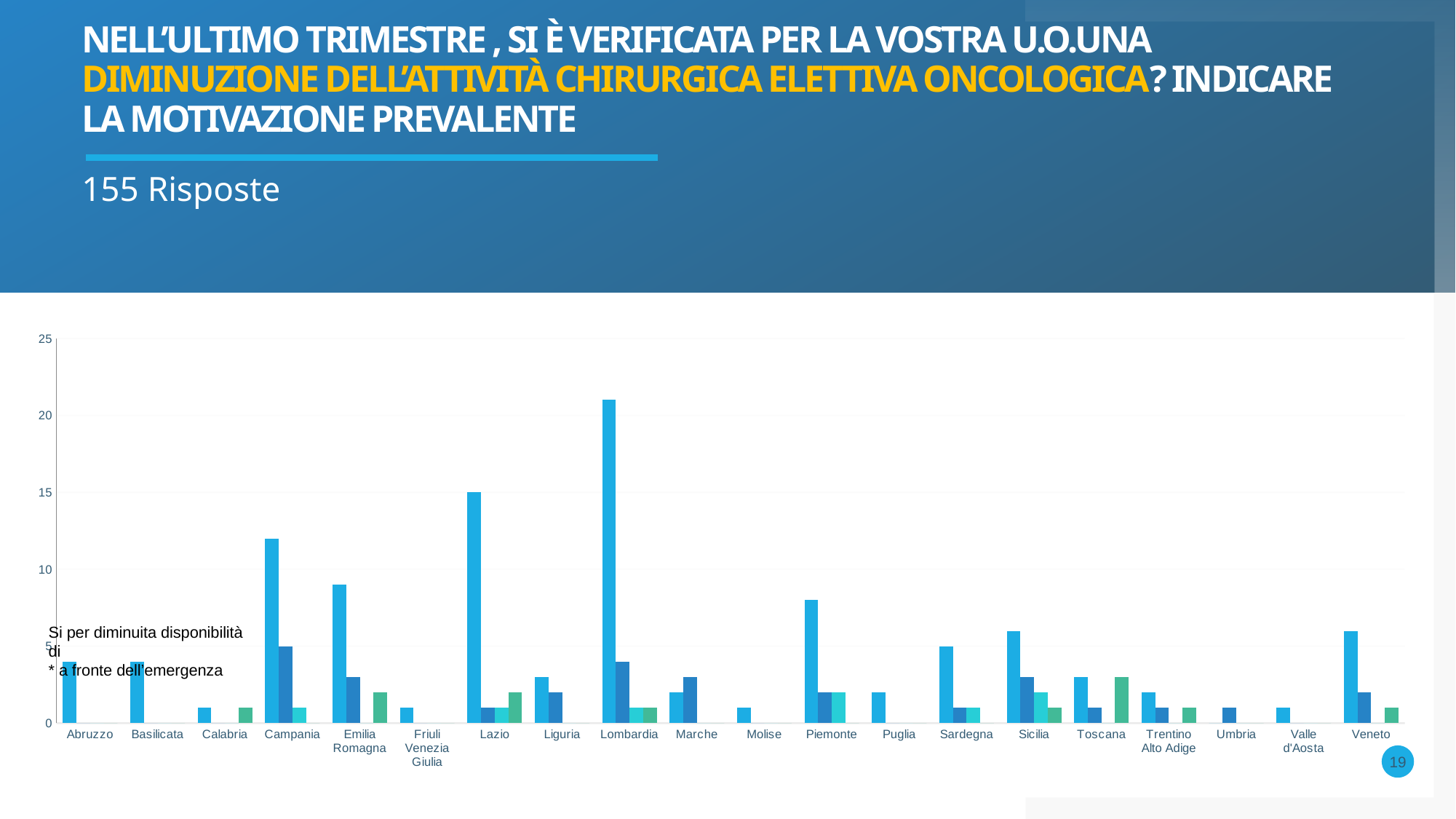
Is the value of the light blue bar for Abruzzo greater or less than 5? less Is the value of the light blue bar for Campania greater or less than 10? greater Is the value of the light blue bar for Emilia Romagna greater or less than 10? less How many regions (categories) are shown on the x axis of the chart? 20 Which region has the larger light blue bar, Piemonte or Sicilia? Piemonte What kind of chart is shown on the slide? bar chart What is the value of the light blue bar for Lazio? 15 Which region has the tallest bar in the chart? Lombardia Which region has the larger light blue bar, Lazio or Campania? Lazio How many responses does the slide say the chart is based on? 155 Risposte